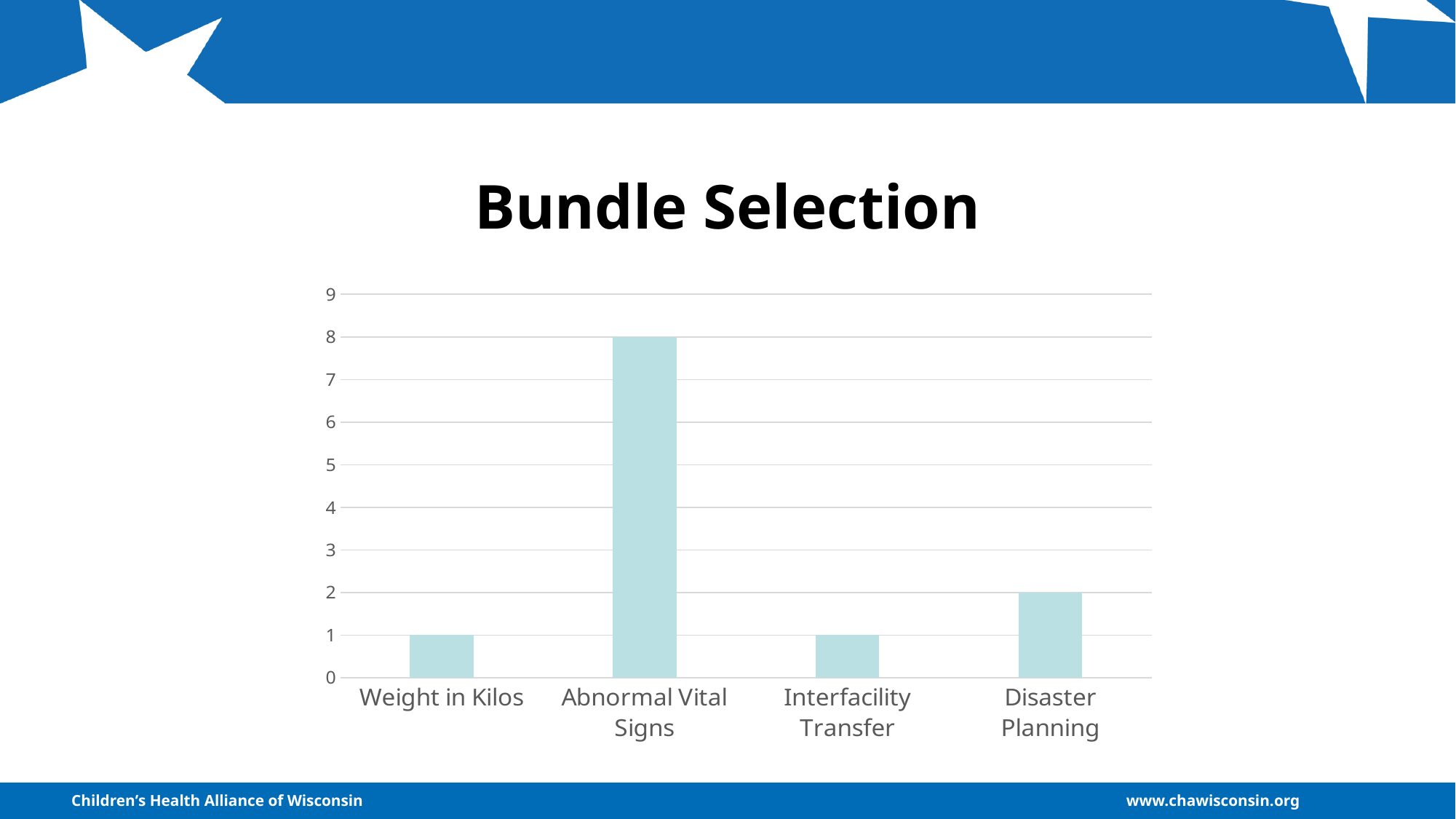
What is the value for Interfacility Transfer? 1 What is the value for Weight in Kilos? 1 What is the value for Abnormal Vital Signs? 8 What type of chart is shown on the slide? bar chart Is the value for Abnormal Vital Signs greater or less than 5? greater Which is larger, the value for Disaster Planning or the value for Weight in Kilos? Disaster Planning What is the title of the chart? Bundle Selection Which category has the highest value? Abnormal Vital Signs What is the value for Disaster Planning? 2 How many categories are shown on the x axis of the chart? 4 What is the highest value shown on the y axis? 9 What is the difference between the values for Abnormal Vital Signs and Disaster Planning? 6